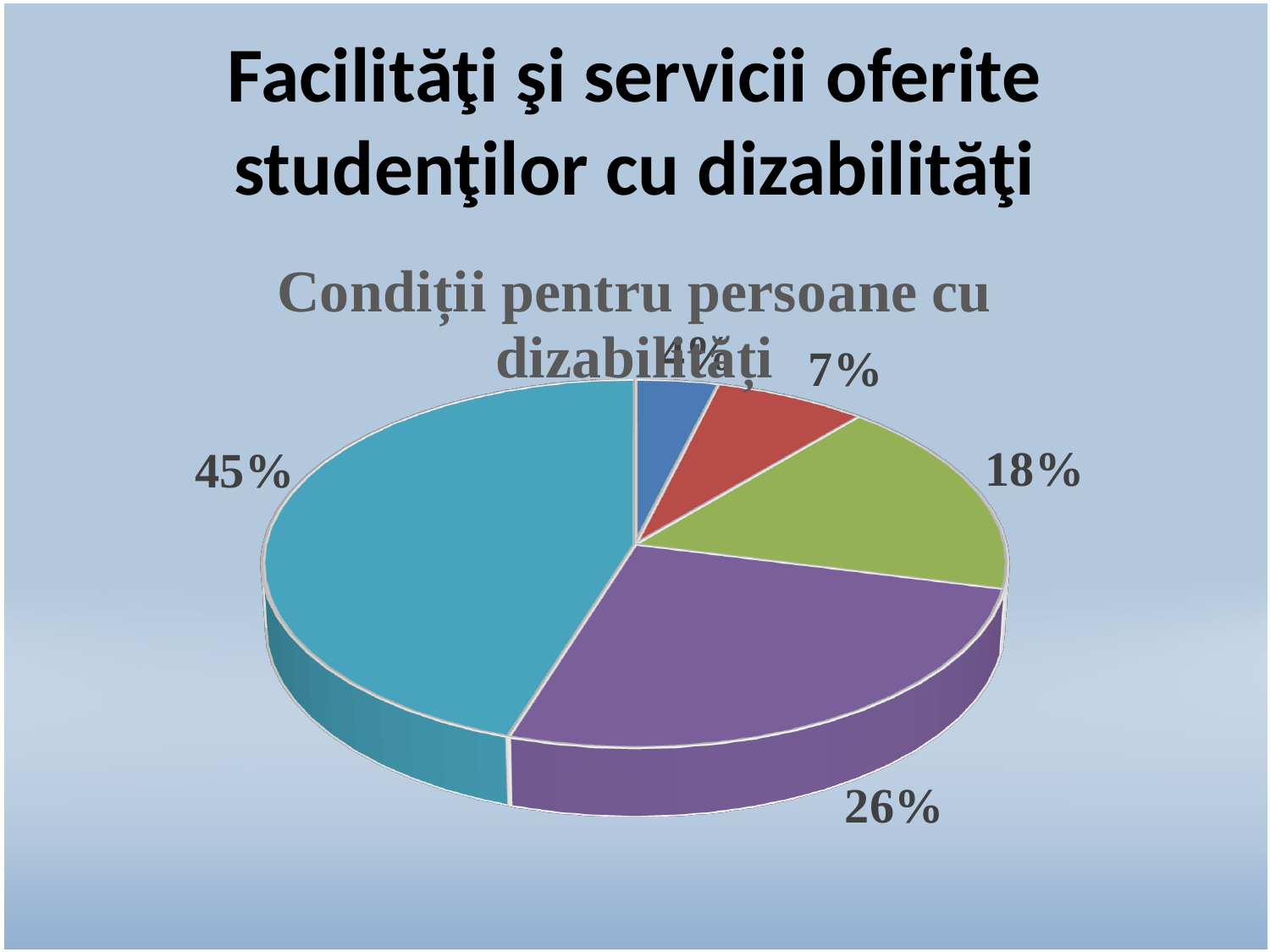
What is the difference in percentage points between the purple slice and the green slice? 8 percentage points Which slice is the largest in the pie chart? The teal slice (45%) Which is larger, the green slice or the red slice? The green slice How many slices does the pie chart have? 5 What percentage is shown for the large teal slice? 45% What percentage is shown for the purple slice? 26% What kind of chart is shown on the slide? Pie chart What is the title of the chart? Condiții pentru persoane cu dizabilități What percentage is shown for the green slice? 18% What percentage is shown for the red slice? 7% Which slice is the smallest in the pie chart? The blue slice What is the difference in percentage points between the teal slice and the purple slice? 19 percentage points